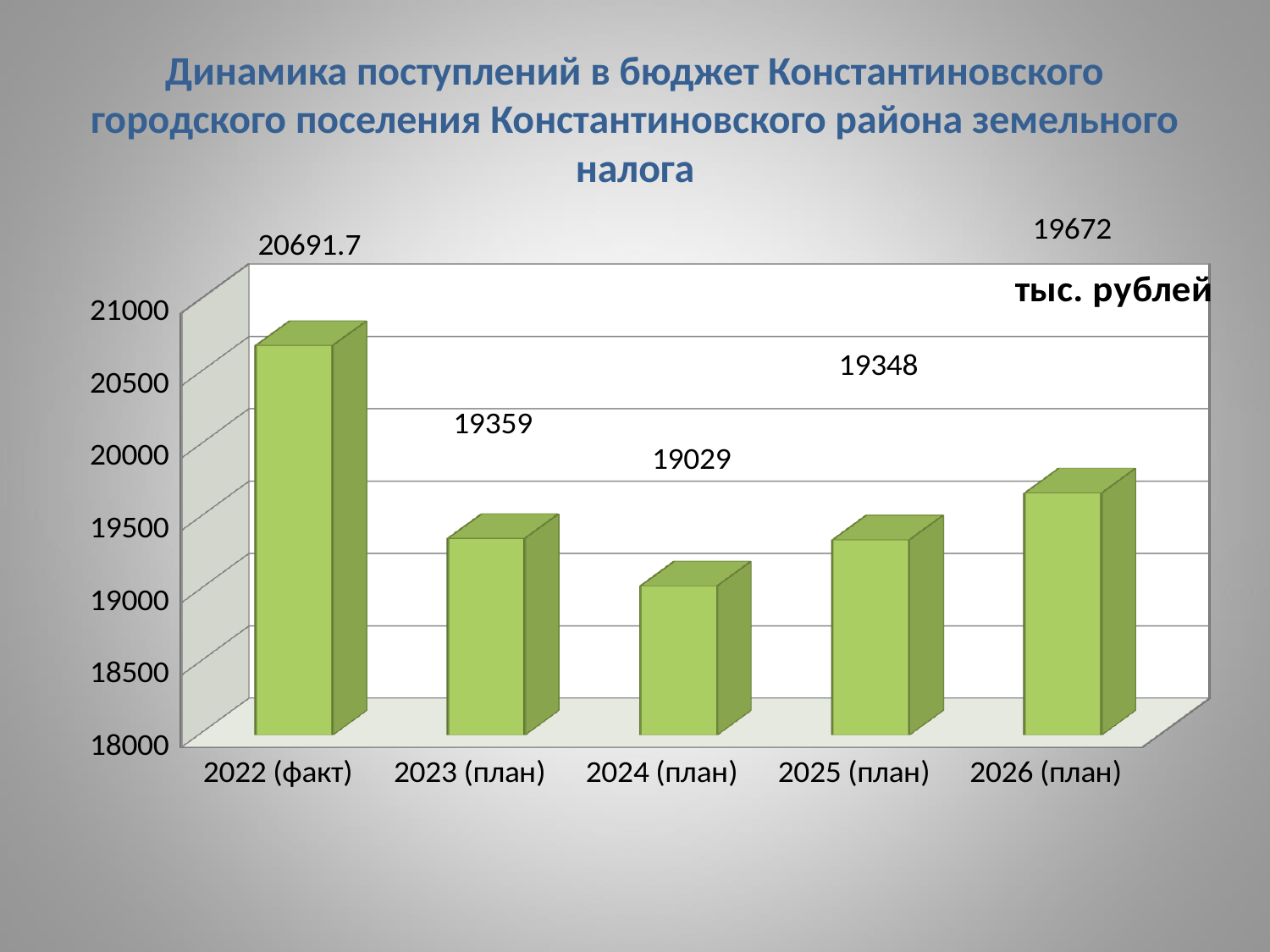
What is the value for 2022 (факт)? 20691.7 What is the difference between the values for 2022 (факт) and 2023 (план)? 1332.7 What kind of chart is shown on the slide? bar chart Which is larger, the value for 2022 (факт) or the value for 2026 (план)? 2022 (факт) Which category has the highest value? 2022 (факт) What is the value for 2026 (план)? 19672 Which category has the lowest value? 2024 (план) What is the difference between the values for 2026 (план) and 2024 (план)? 643 What is the value for 2024 (план)? 19029 Is the value for 2024 (план) greater or less than 19500? less Do the values rise or fall from 2024 (план) to 2026 (план)? rise How many categories are shown on the x axis? 5